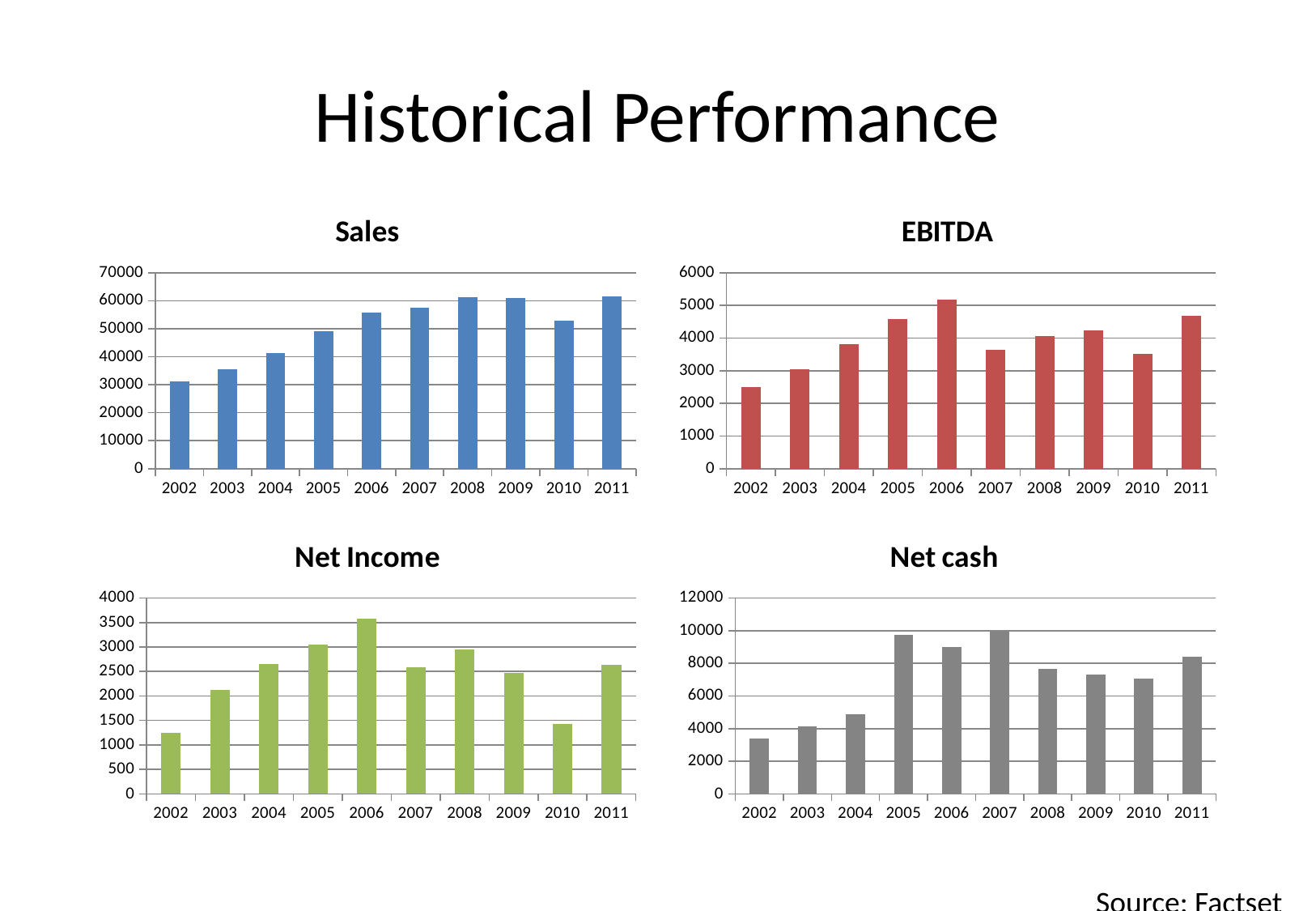
In the EBITDA chart, is the value for 2010 greater or less than 4000? less In the Net cash chart, is the value for 2011 greater or less than 8000? greater What kind of chart is the Sales chart? bar chart In the Net cash chart, which year has the lowest value? 2002 In the Net Income chart, which year has the highest value? 2006 In the EBITDA chart, which year has the highest value? 2006 In the Sales chart, is the value for 2010 greater or less than 60000? less How many years are shown on the x axis of the Net cash chart? 10 In the EBITDA chart, which is larger, the value for 2005 or the value for 2007? 2005 In the Sales chart, which year has the lowest value? 2002